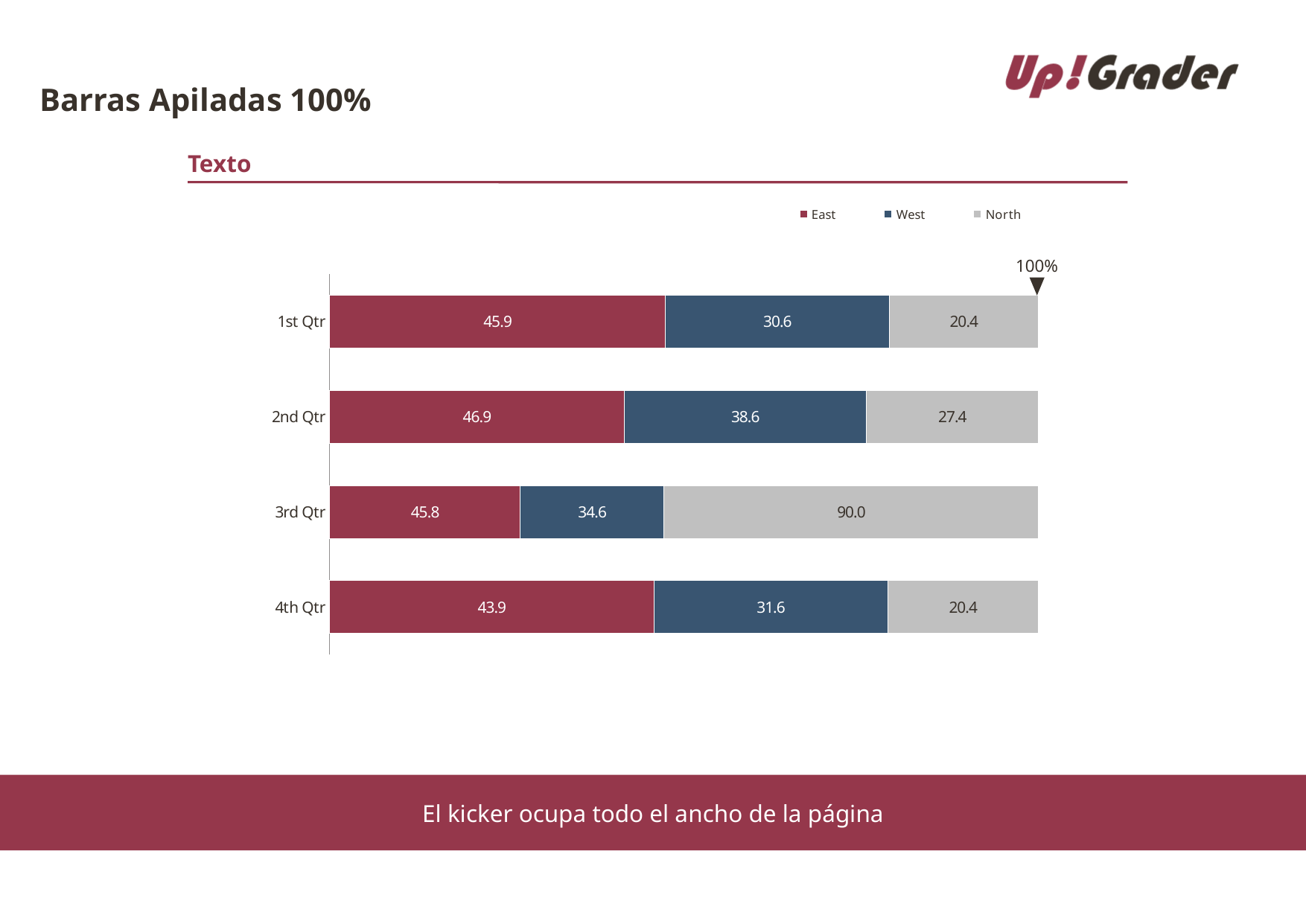
How many series does the legend list? 3 What kind of chart is shown on the slide? 100% stacked bar chart What is the East value for 2nd Qtr? 46.9 What is the difference between the North values for 3rd Qtr and 2nd Qtr? 62.6 Which series is shown in grey in the legend? North How many quarters are shown on the chart? 4 Which is larger, the West value for 1st Qtr or the West value for 3rd Qtr? 3rd Qtr Which quarter has the lowest East value? 4th Qtr What is the West value for 4th Qtr? 31.6 What is the North value for 3rd Qtr? 90.0 What is the total of the three values in the 1st Qtr bar? 96.9 Which quarter has the highest West value? 2nd Qtr